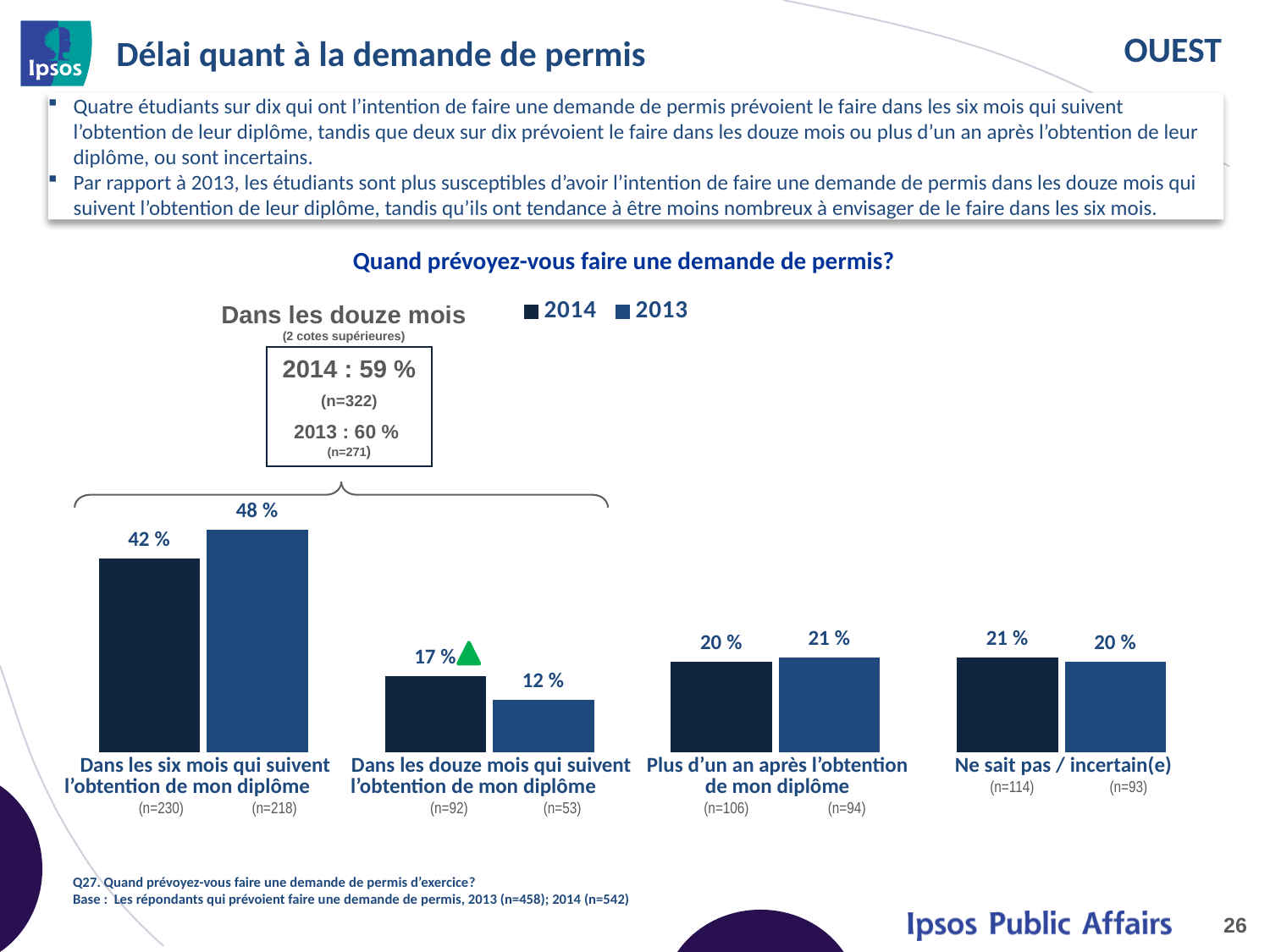
What is the difference between the 2013 and 2014 values for "Dans les six mois qui suivent l'obtention de mon diplôme"? 6 % How many series does the chart legend list? 2 What is the 2013 value for "Dans les six mois qui suivent l'obtention de mon diplôme"? 48 % What is the 2014 value for "Dans les six mois qui suivent l'obtention de mon diplôme"? 42 % What is the difference between the 2014 and 2013 values for "Dans les douze mois qui suivent l'obtention de mon diplôme"? 5 % For "Dans les douze mois qui suivent l'obtention de mon diplôme", which year has the larger value, 2014 or 2013? 2014 What is the 2014 value for "Dans les douze mois qui suivent l'obtention de mon diplôme"? 17 % Which category has the lowest 2013 value? Dans les douze mois qui suivent l'obtention de mon diplôme What is the 2013 value for "Ne sait pas / incertain(e)"? 20 % How many categories are shown on the x axis of the chart? 4 What kind of chart is shown on the slide? Bar chart Which category has the highest 2013 value? Dans les six mois qui suivent l'obtention de mon diplôme